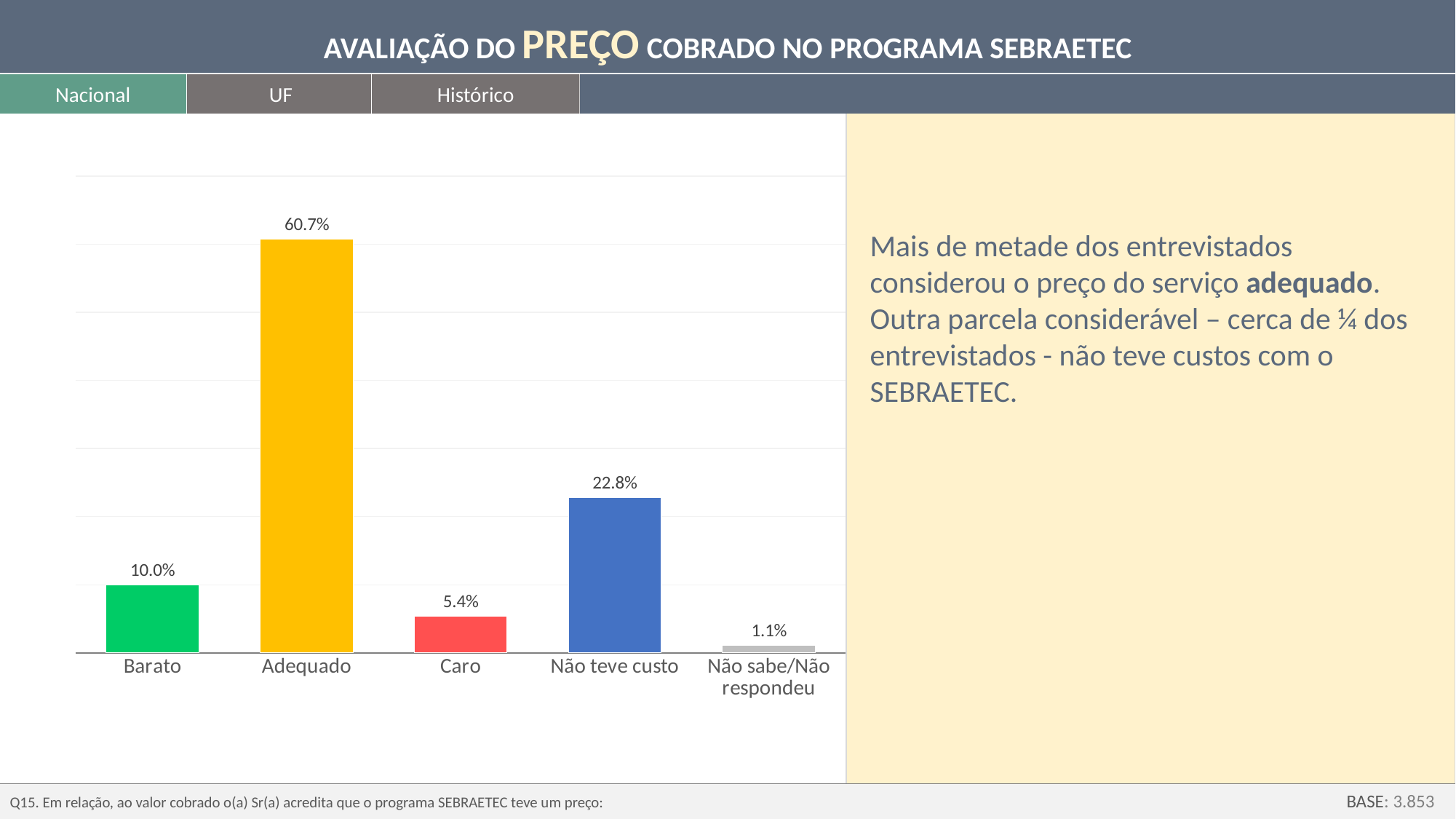
What is the difference between the values for Adequado and Não teve custo? 37.9% What is the value for Não teve custo? 22.8% What colour is the bar for Adequado? Yellow Which category has the highest value? Adequado What is the value for Adequado? 60.7% How many categories are shown on the x axis? 5 What kind of chart is shown on the slide? Bar chart Which category has the lowest value? Não sabe/Não respondeu What is the value for Caro? 5.4% What is the value for Não sabe/Não respondeu? 1.1% Which is larger, the value for Barato or the value for Caro? Barato What is the value for Barato? 10.0%